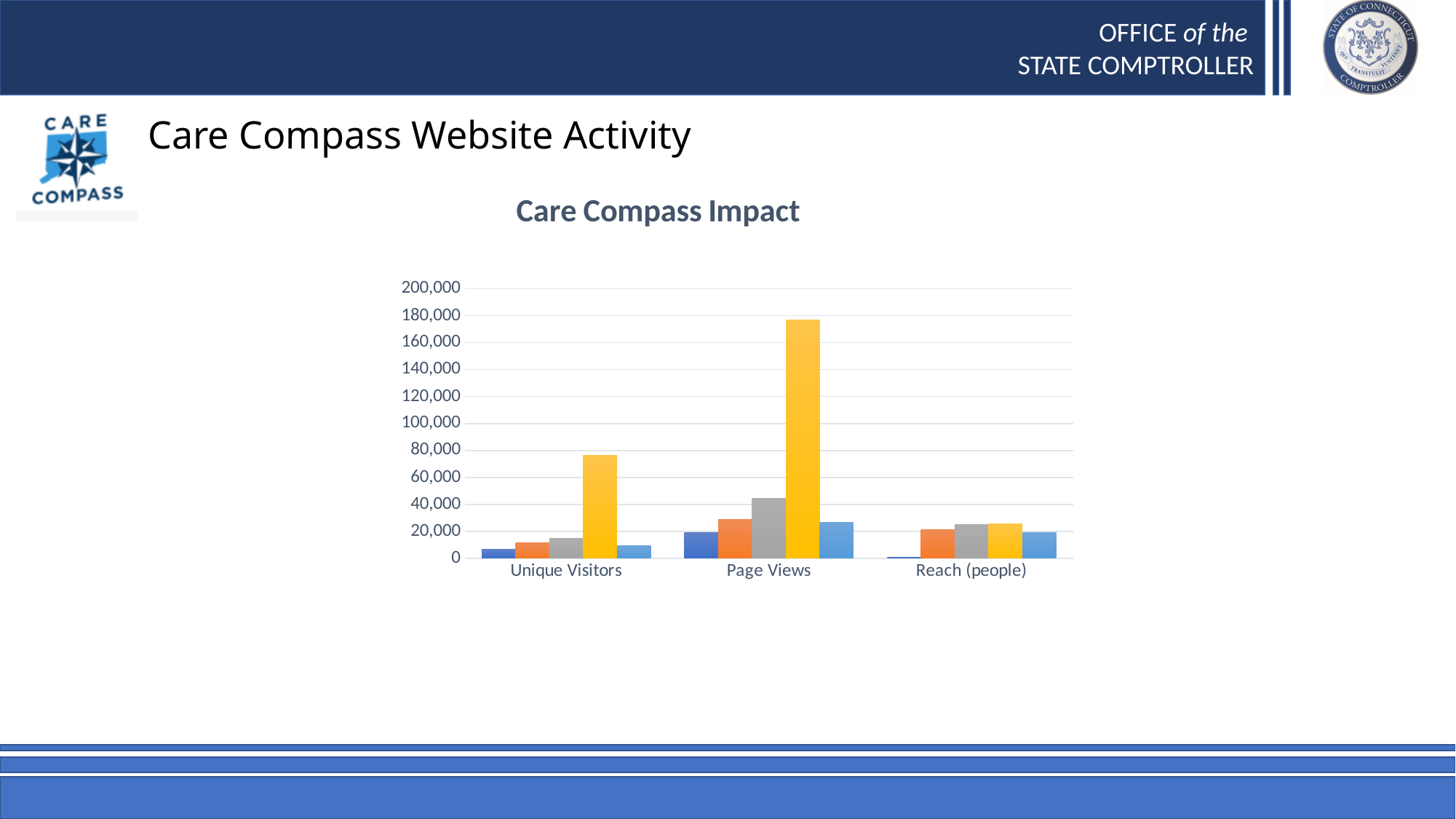
Is the value of the yellow bar for Unique Visitors greater or less than 60,000? greater What is the highest value shown on the vertical axis of the chart? 200,000 Is the value of the yellow bar for Page Views greater or less than 180,000? less What kind of chart is shown on the slide? bar chart Which is larger: the gray bar for Page Views or the gray bar for Unique Visitors? Page Views Is the value of the yellow bar for Page Views greater or less than 160,000? greater Which category contains the tallest bar in the chart? Page Views How many categories are shown on the x axis of the chart? 3 Which is larger: the yellow bar for Unique Visitors or the yellow bar for Reach (people)? Unique Visitors What is the title of the chart? Care Compass Impact